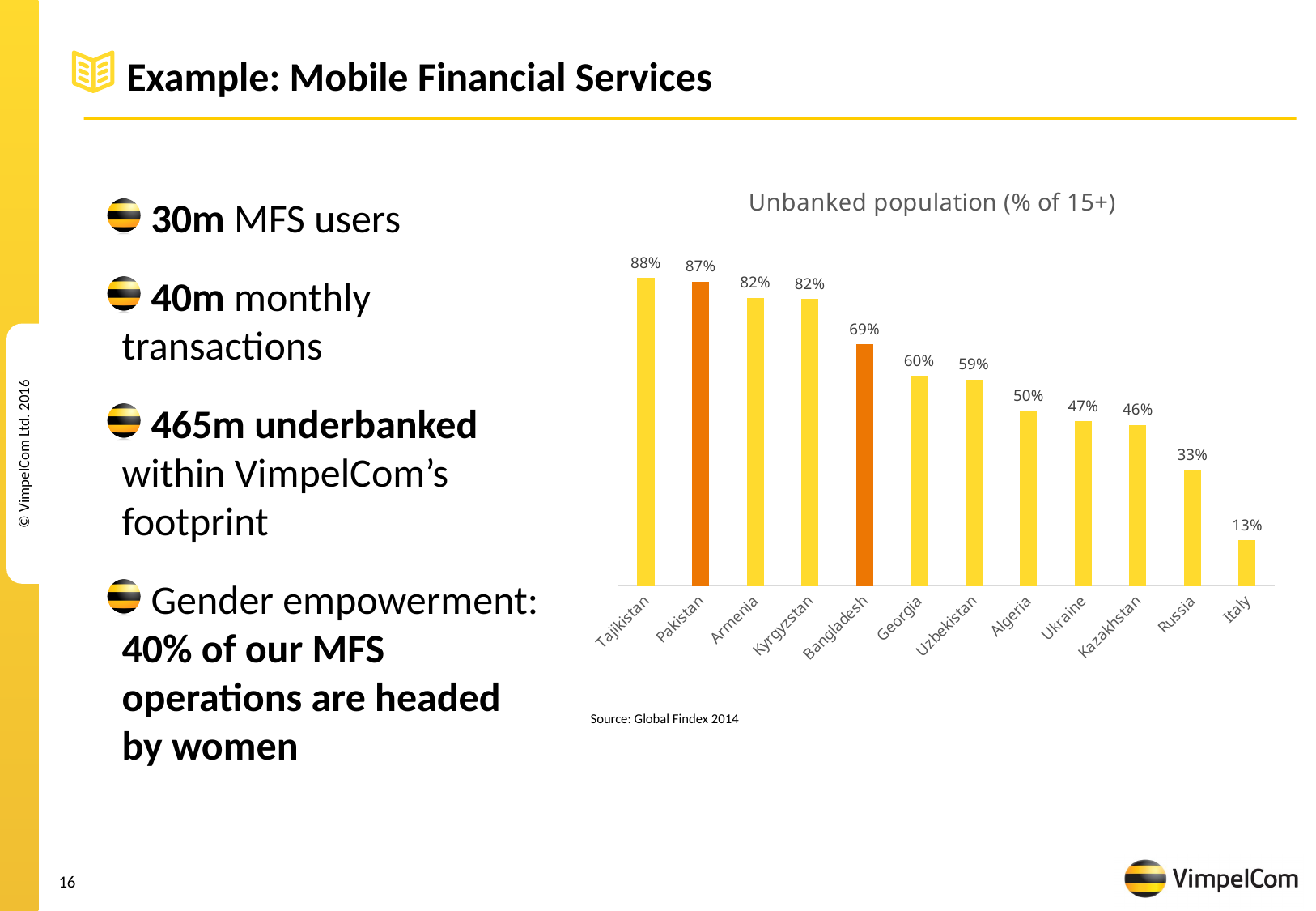
What is the unbanked population percentage for Russia? 33% What is the title of the chart? Unbanked population (% of 15+) What is the unbanked population percentage for Tajikistan? 88% Which country has the lowest unbanked population percentage? Italy Do the values rise or fall from left to right across the chart? Fall What is the difference in unbanked population percentage between Pakistan and Italy? 74% How many countries are shown in the chart? 12 Which country has the highest unbanked population percentage? Tajikistan What is the difference in unbanked population percentage between Georgia and Kazakhstan? 14% Which has a higher unbanked population percentage, Algeria or Ukraine? Algeria What type of chart is used to show the unbanked population? Bar chart What is the unbanked population percentage for Bangladesh? 69%